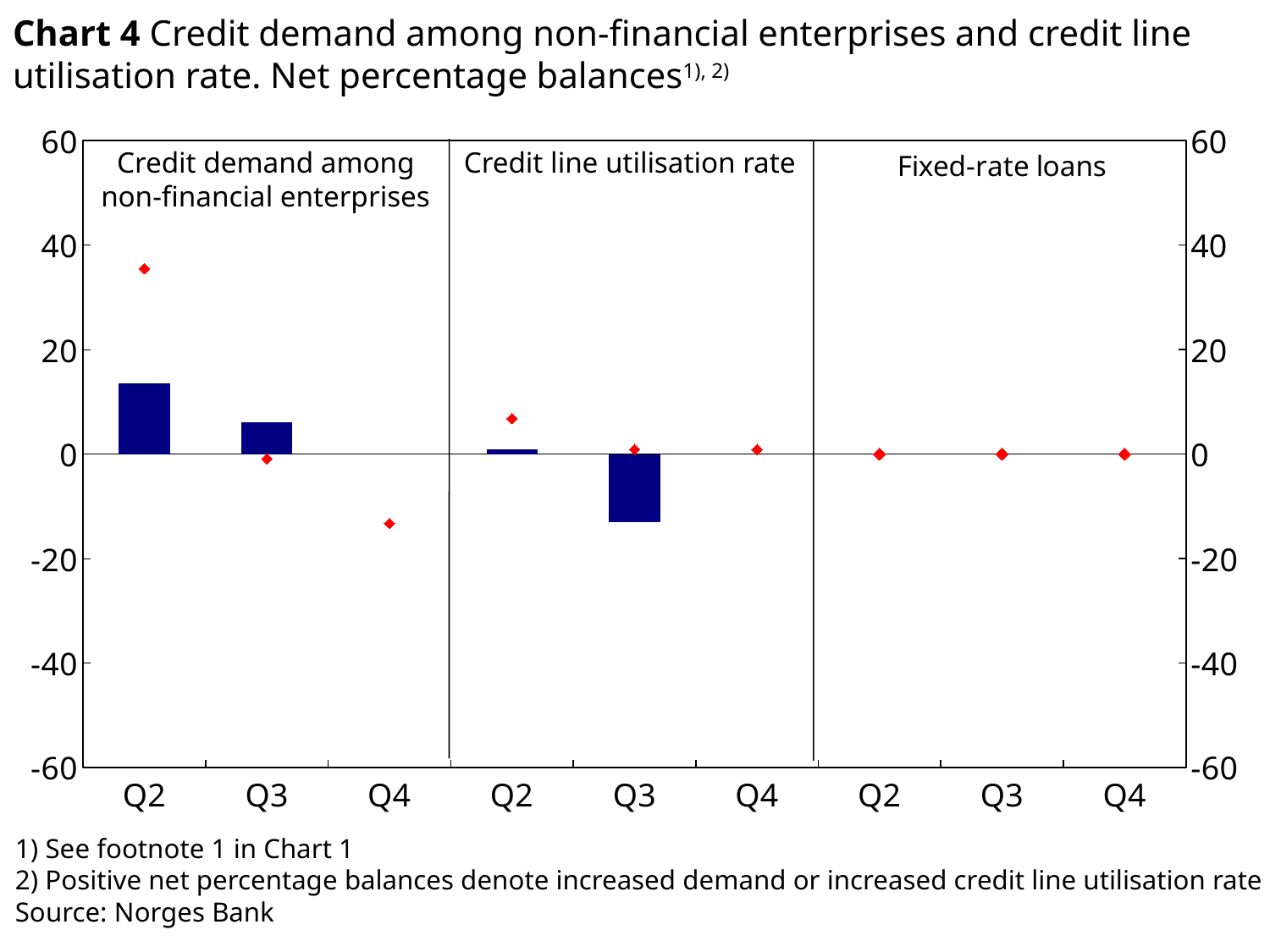
In the 'Credit demand among non-financial enterprises' panel, is the bar for Q2 greater or less than 20? less What kind of chart is shown on the slide? combination bar and line chart (bars with red diamond markers) In the 'Credit demand among non-financial enterprises' panel, which bar is taller, Q2 or Q3? Q2 In the 'Credit line utilisation rate' panel, is the bar for Q3 greater or less than 0? less In the 'Credit demand among non-financial enterprises' panel, is the red marker for Q2 greater or less than 20? greater In the 'Credit demand among non-financial enterprises' panel, which quarter has the highest bar? Q2 How many panels does the chart have? 3 What is the title of the rightmost panel of the chart? Fixed-rate loans In the 'Credit line utilisation rate' panel, which quarter has the lowest bar? Q3 In the 'Credit demand among non-financial enterprises' panel, do the red markers rise or fall from Q2 to Q4? fall How many quarters are shown on the x axis of the 'Credit demand among non-financial enterprises' panel? 3